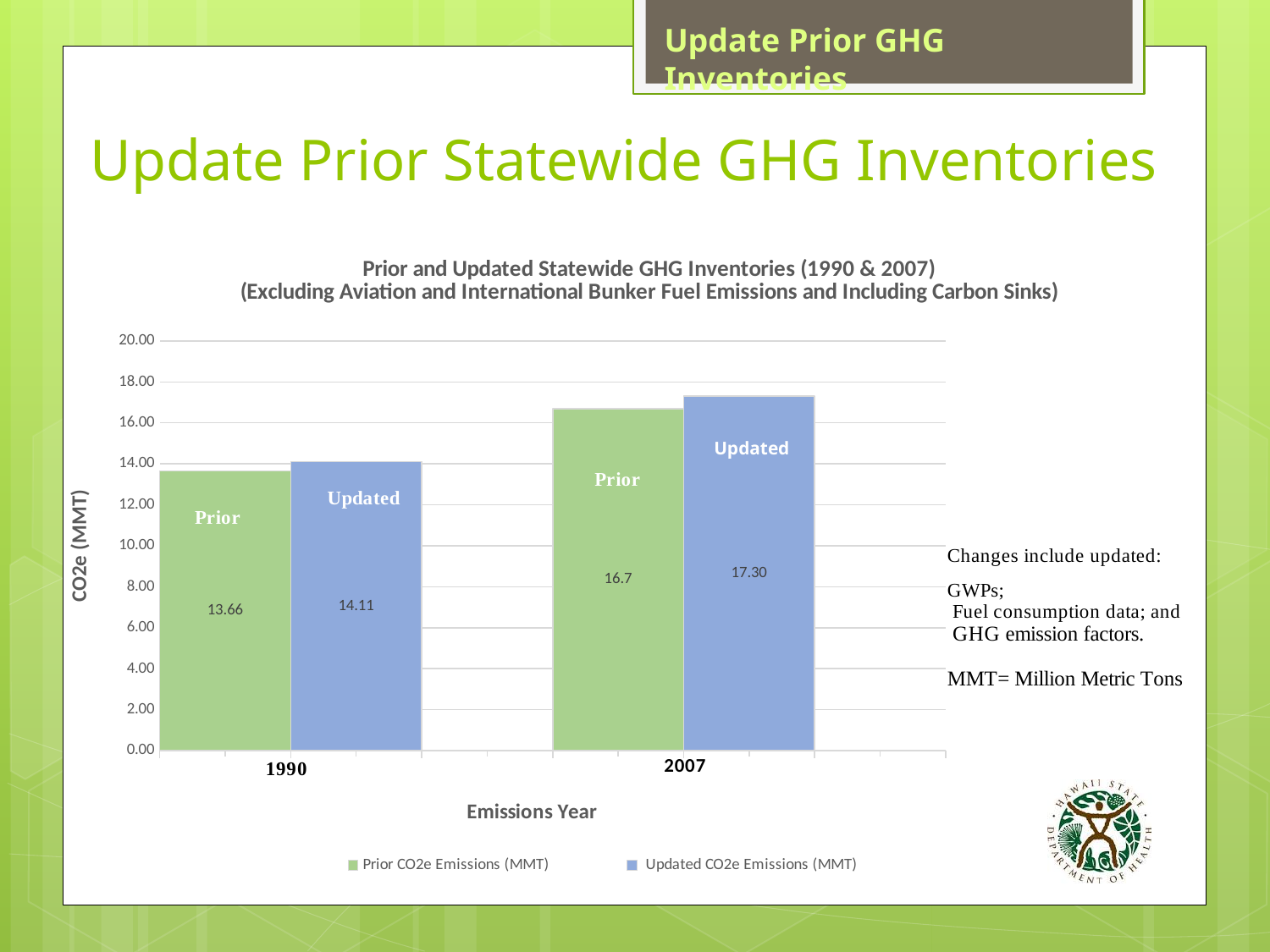
Which bar shows the lowest value on the chart? Prior CO2e Emissions for 1990 How many emissions years are shown on the x axis? 2 What kind of chart is shown on the slide? Bar chart How many series does the legend list? 2 Which is larger for 2007, the Prior or the Updated CO2e Emissions value? Updated What is the Updated CO2e Emissions value for 1990? 14.11 What is the label of the y axis? CO2e (MMT) What is the Updated CO2e Emissions value for 2007? 17.30 What is the Prior CO2e Emissions value for 2007? 16.7 What is the difference between the Updated and Prior CO2e Emissions values for 1990? 0.45 What is the Prior CO2e Emissions value for 1990? 13.66 Which bar shows the highest value on the chart? Updated CO2e Emissions for 2007